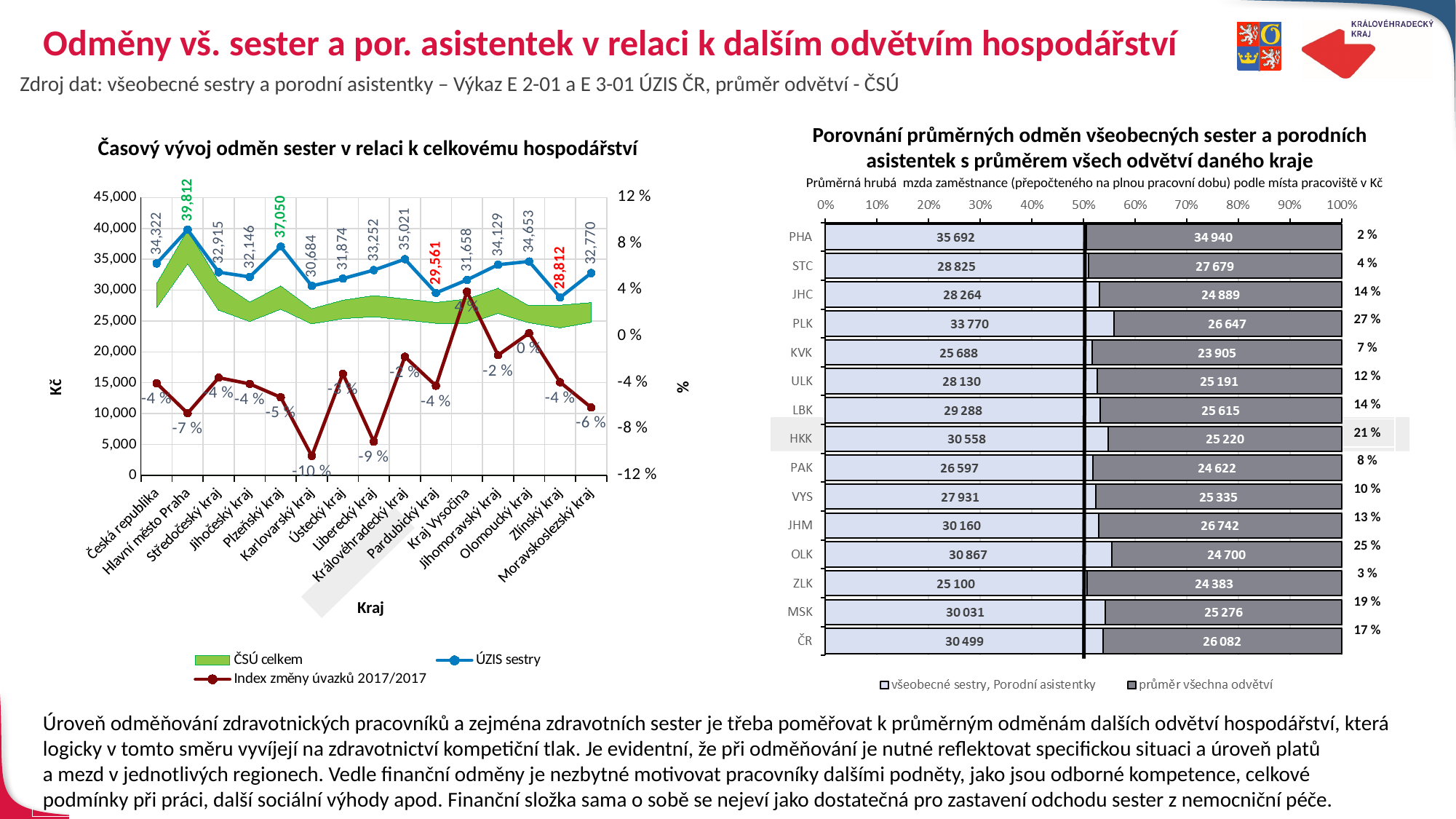
How many regions (categories) are shown in the right chart 'Porovnání průměrných odměn všeobecných sester a porodních asistentek s průměrem všech odvětví daného kraje'? 15 In the right chart 'Porovnání průměrných odměn všeobecných sester a porodních asistentek s průměrem všech odvětví daného kraje', which region has the highest value for všeobecné sestry, Porodní asistentky? PHA In the left chart 'Časový vývoj odměn sester v relaci k celkovému hospodářství', what is the Index změny úvazků value for Karlovarský kraj? -10 % In the left chart 'Časový vývoj odměn sester v relaci k celkovému hospodářství', what is the difference between the ÚZIS sestry values for Plzeňský kraj and Pardubický kraj? 7,489 In the right chart 'Porovnání průměrných odměn všeobecných sester a porodních asistentek s průměrem všech odvětví daného kraje', what is the průměr všechna odvětví value for PLK? 26 647 In the right chart 'Porovnání průměrných odměn všeobecných sester a porodních asistentek s průměrem všech odvětví daného kraje', which is larger: the všeobecné sestry, Porodní asistentky value for JHM or for VYS? JHM In the right chart 'Porovnání průměrných odměn všeobecných sester a porodních asistentek s průměrem všech odvětví daného kraje', what is the value for všeobecné sestry, Porodní asistentky in HKK? 30 558 What type of chart is the right chart 'Porovnání průměrných odměn všeobecných sester a porodních asistentek s průměrem všech odvětví daného kraje'? Bar chart In the right chart 'Porovnání průměrných odměn všeobecných sester a porodních asistentek s průměrem všech odvětví daného kraje', what percentage is shown to the right of the bar for OLK? 25 % In the left chart 'Časový vývoj odměn sester v relaci k celkovému hospodářství', what is the ÚZIS sestry value for Hlavní město Praha? 39,812 How many series does the legend of the left chart 'Časový vývoj odměn sester v relaci k celkovému hospodářství' list? 3 In the left chart 'Časový vývoj odměn sester v relaci k celkovému hospodářství', which region has the lowest ÚZIS sestry value? Zlínský kraj